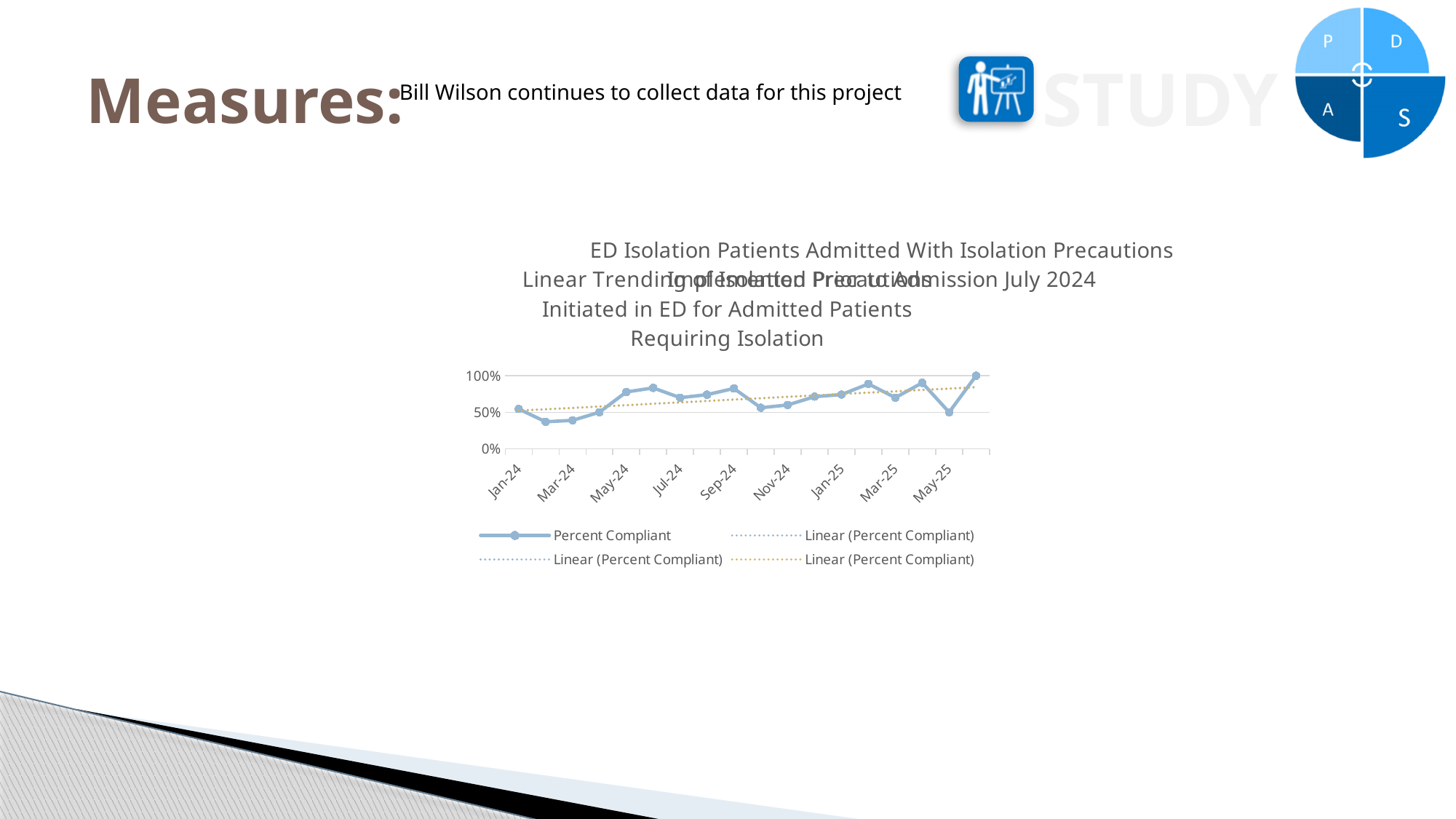
What is the first month shown on the x axis of the chart? Jan-24 How many monthly data points are plotted on the Percent Compliant line? 18 What is the name of the plotted data series in the chart's legend? Percent Compliant Which month has the highest Percent Compliant value? Jun-25 Does the dotted linear trend line rise or fall from Jan-24 to Jun-25? rise How many entries does the chart's legend list? 4 Is the Percent Compliant value for Mar-25 greater or less than 50%? greater Is the Percent Compliant value for May-24 greater or less than 50%? greater What kind of chart is shown on the slide? line chart